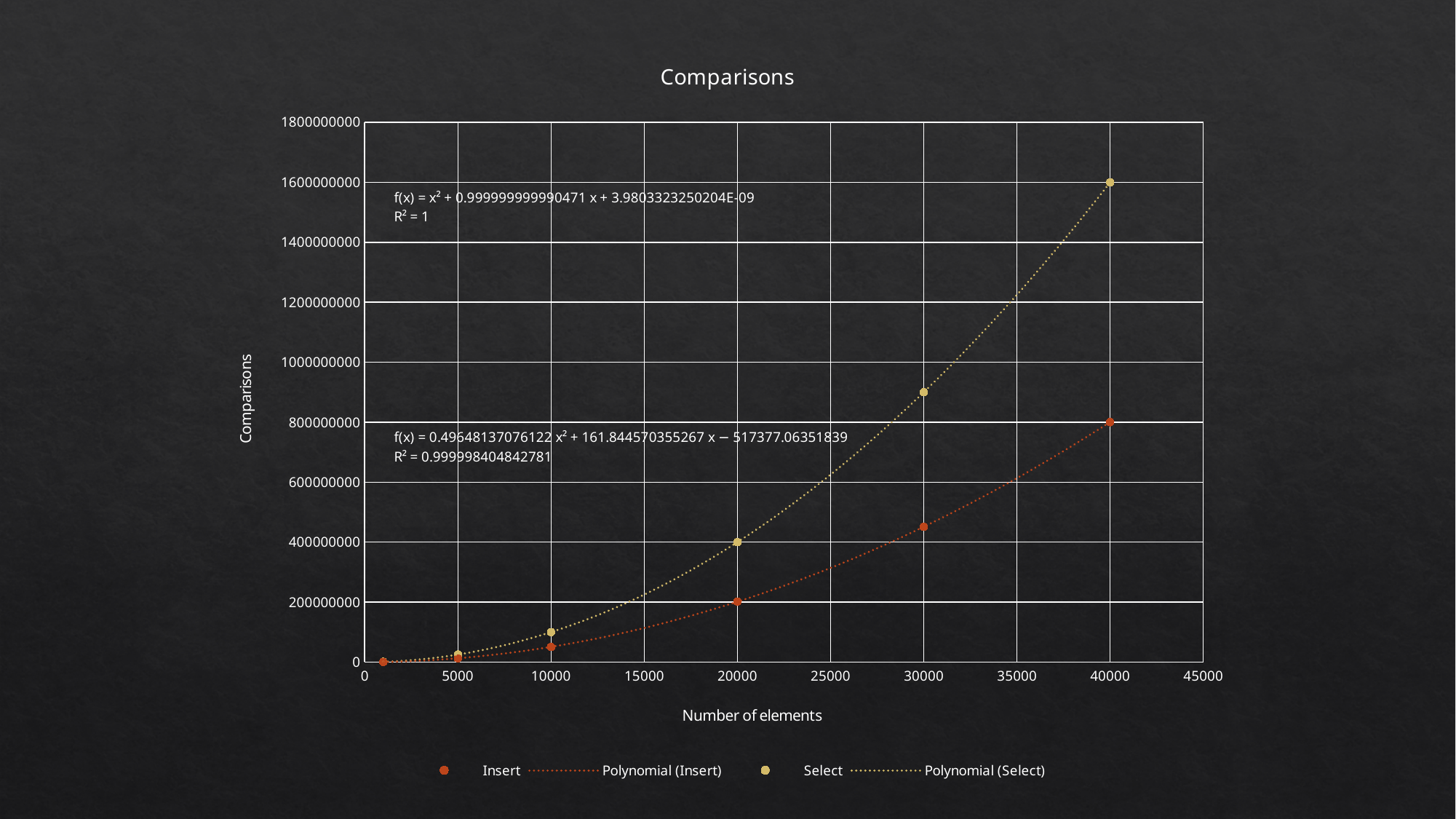
What type of chart is shown on the slide? scatter chart At 40000 elements, which series has the larger value, Insert or Select? Select Do the Select values rise or fall as the number of elements increases? rise Is the Select value at 30000 elements greater or less than 800000000? greater How many entries does the legend list? 4 Is the Insert value at 30000 elements greater or less than 600000000? less What is the R² value shown for the Select polynomial trendline? 1